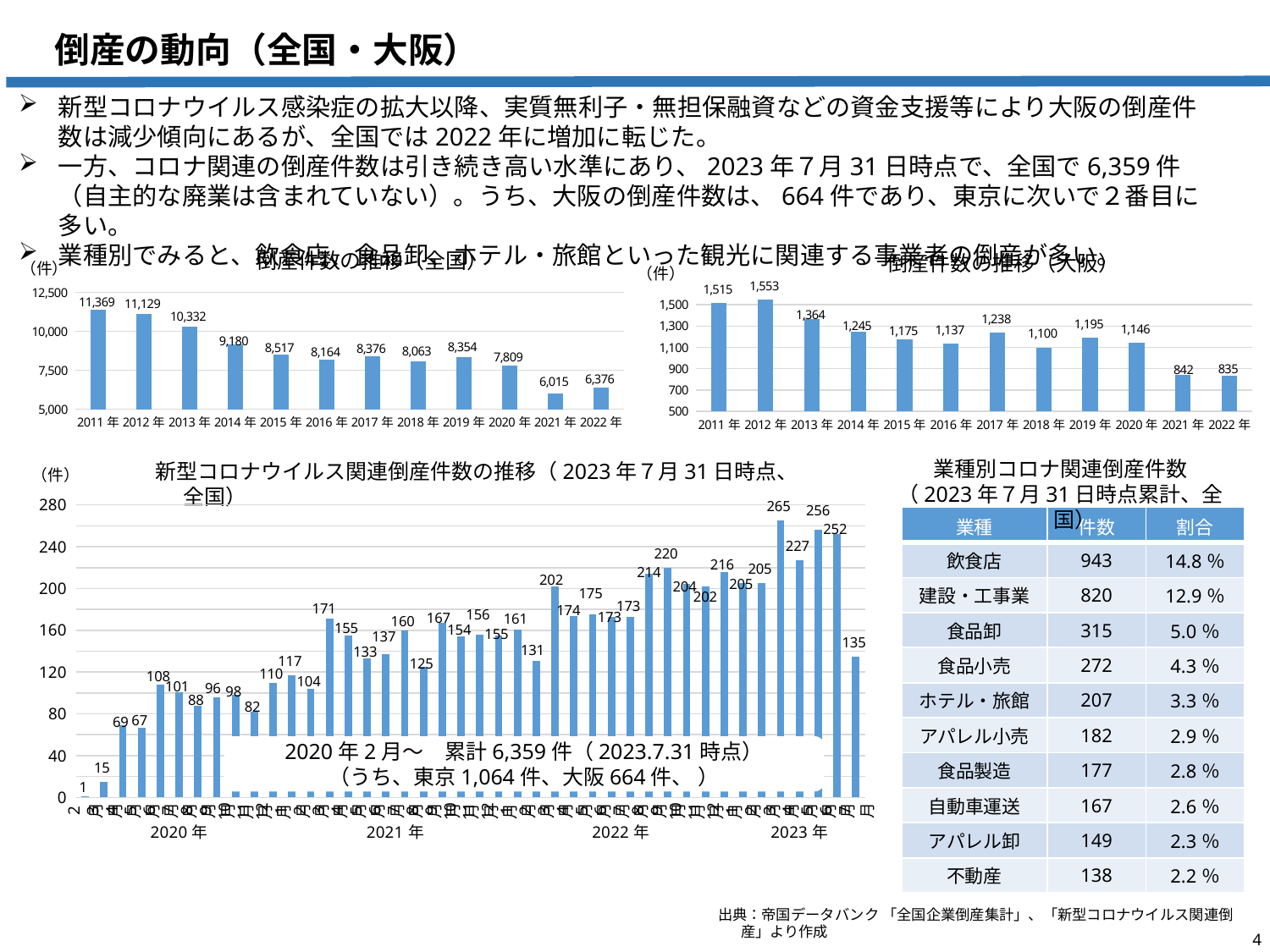
In the chart titled 倒産件数の推移（大阪）, which year has the highest value? 2012年 In the chart titled 倒産件数の推移（全国）, which is larger, the value for 2017年 or 2018年? 2017年 What kind of chart is the bottom chart titled 新型コロナウイルス関連倒産件数の推移? bar chart In the chart titled 倒産件数の推移（全国）, which year has the lowest value? 2021年 In the chart titled 倒産件数の推移（大阪）, what is the value for 2012年? 1,553 In the chart titled 倒産件数の推移（全国）, do the values rise or fall from 2011年 to 2016年? fall In the chart titled 倒産件数の推移（全国）, what is the difference between the values for 2022年 and 2021年? 361 In the bottom chart titled 新型コロナウイルス関連倒産件数の推移, what is the highest value shown? 265 In the chart titled 倒産件数の推移（大阪）, what is the value for 2021年? 842 In the chart titled 倒産件数の推移（全国）, what is the value for 2022年? 6,376 In the chart titled 倒産件数の推移（大阪）, how many years are plotted? 12 In the chart titled 倒産件数の推移（全国）, which year has the highest value? 2011年